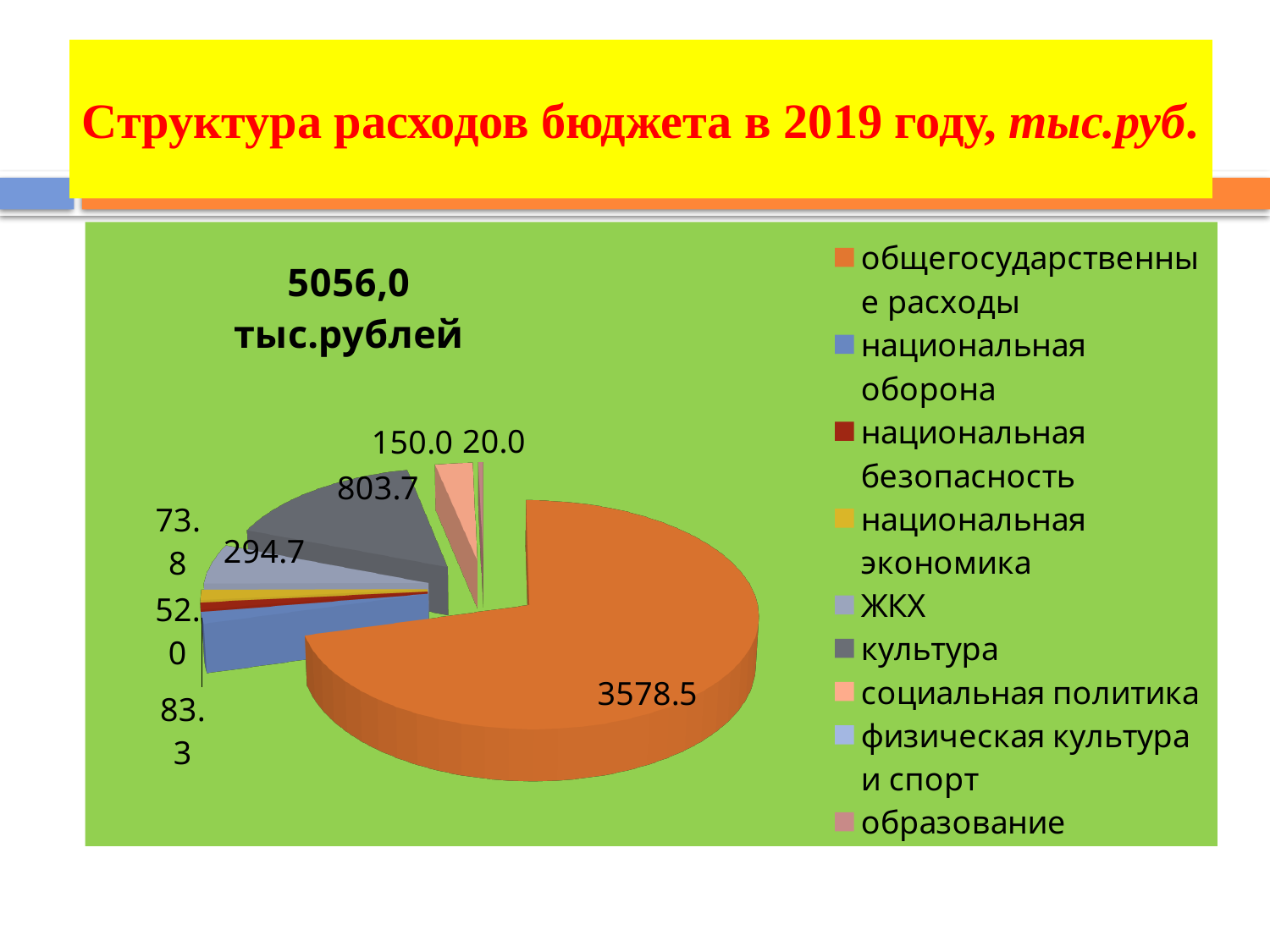
Which of the labelled slices has the smallest value? образование What is the difference between the values for культура and ЖКХ? 509.0 Which is larger, the value for культура or the value for социальная политика? культура What is the value for культура? 803.7 What kind of chart is shown on the slide? pie chart What is the value for ЖКХ? 294.7 What is the value for социальная политика? 150.0 Which category has the largest slice of the pie? общегосударственные расходы What total is shown in the chart title? 5056,0 тыс.рублей How many categories does the legend list? 9 What is the value for общегосударственные расходы? 3578.5